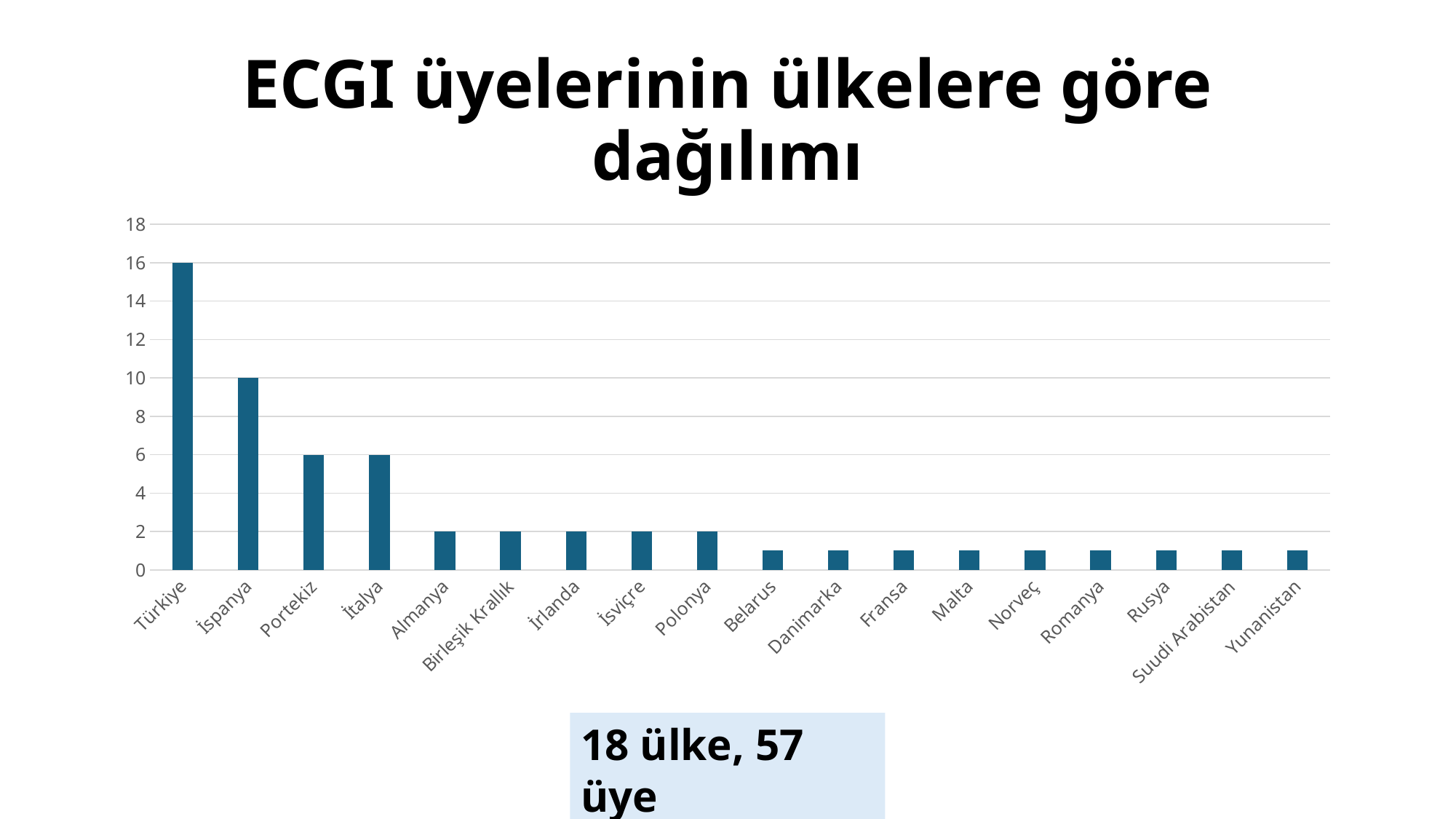
What is the value for İspanya? 10 Is the value for Yunanistan greater or less than 2? less What is the difference between the values for Türkiye and İspanya? 6 How many countries are shown on the x axis of the chart? 18 Which country has the highest value in the chart? Türkiye What is the value for Portekiz? 6 Do the values rise or fall from left to right along the x axis? fall What kind of chart is shown on the slide? bar chart What is the value for Almanya? 2 What is the value for Türkiye? 16 Which is larger, the value for İspanya or the value for Portekiz? İspanya What is the title of the chart? ECGI üyelerinin ülkelere göre dağılımı